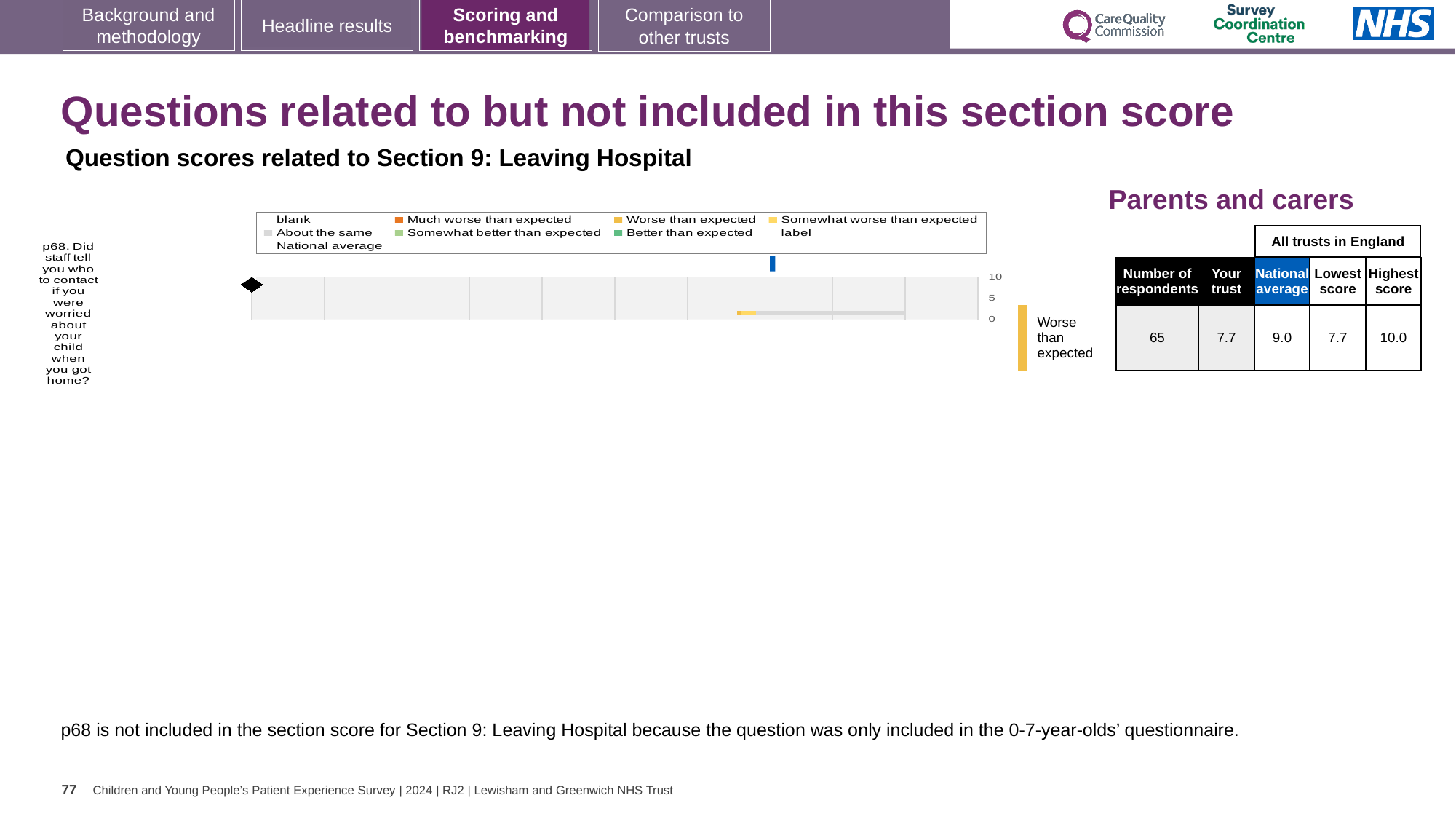
How many survey questions are plotted in the chart? 1 What is the Highest score across all trusts in England for p68? 10.0 What is the highest value shown on the chart's axis? 10 How many respondents answered p68 in the Parents and carers table? 65 What is the Lowest score across all trusts in England for p68? 7.7 What is the difference between the National average and the Your trust score for p68? 1.3 Which question is plotted in the chart? p68. Did staff tell you who to contact if you were worried about your child when you got home? Which is larger for p68, the Your trust score or the National average? National average Which benchmarking category is labelled next to the bar for p68? Worse than expected What kind of chart is shown on the slide? bar chart What is the 'Your trust' score for p68 in the Parents and carers table? 7.7 What is the National average score for p68 in the Parents and carers table? 9.0